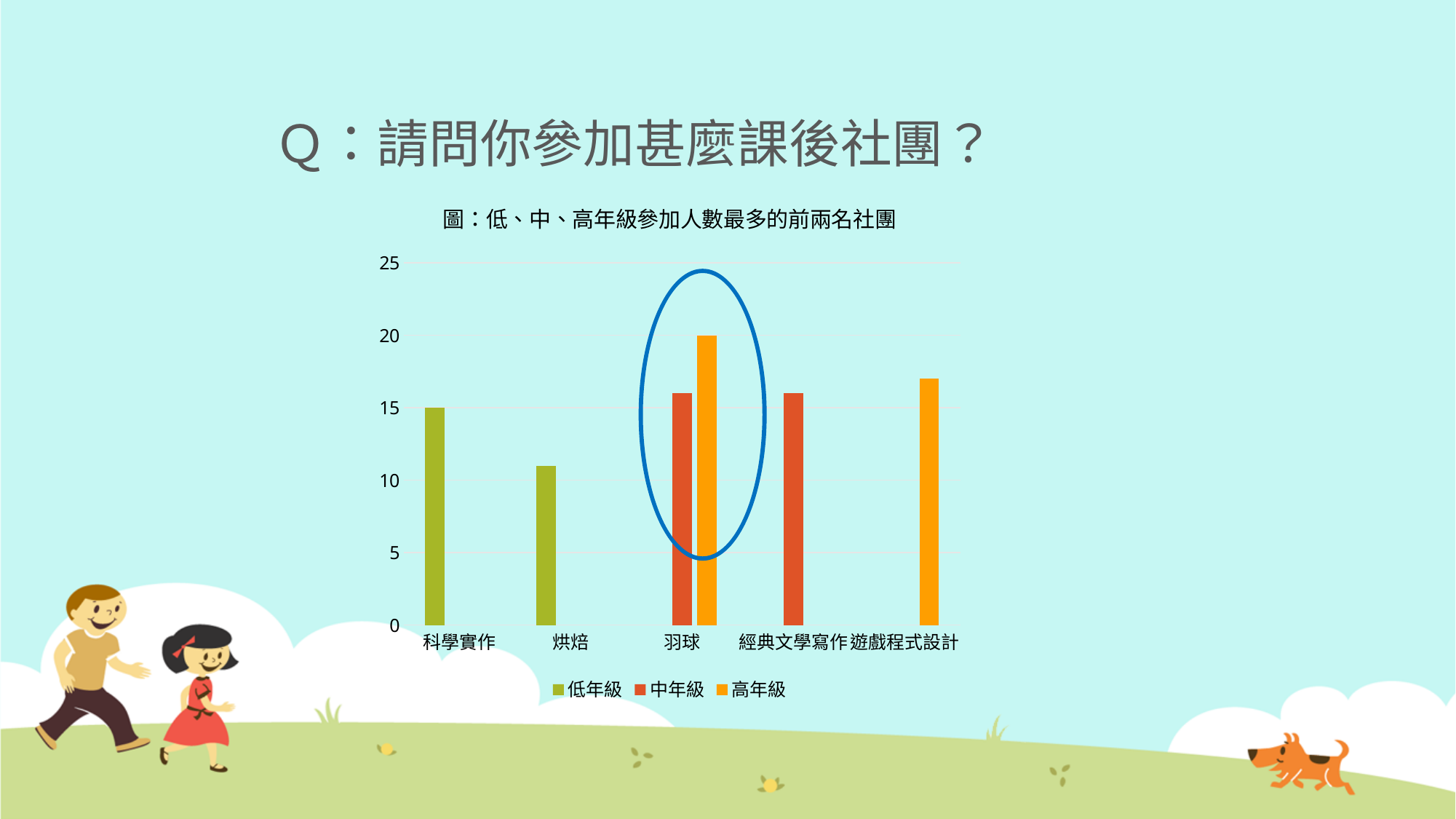
What is the difference between the 高年級 value for 羽球 and the 低年級 value for 科學實作? 5 How many club categories are shown on the x axis? 5 Is the value for 遊戲程式設計 greater or less than 15? greater What kind of chart is shown on the slide? bar chart Which club has the lowest bar in the chart? 烘焙 Which club category is circled in blue on the chart? 羽球 Which bar is the highest in the chart? 高年級 in 羽球 What is the value for 高年級 in 羽球? 20 Which is larger, the 低年級 value for 科學實作 or for 烘焙? 科學實作 How many series does the legend list? 3 Is the value for 烘焙 greater or less than 15? less What is the value for 低年級 in 科學實作? 15